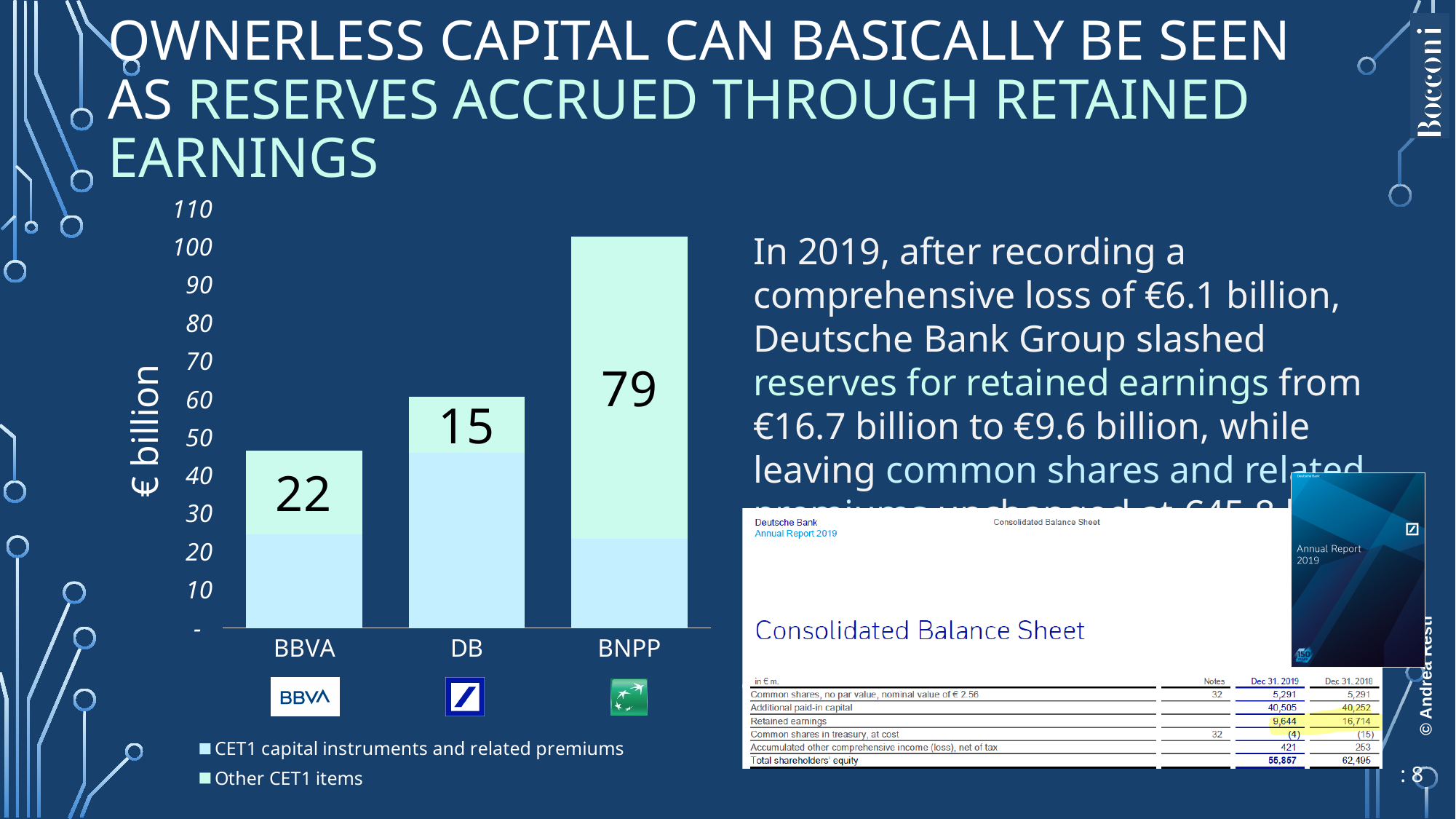
Which bank has the highest value for Other CET1 items? BNPP What is the value of Other CET1 items for BNPP? 79 Which is larger, the Other CET1 items value for BBVA or for DB? BBVA How many banks are shown on the x axis of the chart? 3 Is the total height of the BNPP bar greater or less than 100? greater What is the difference between the Other CET1 items values for BNPP and BBVA? 57 What is the value of Other CET1 items for DB? 15 Is the value of CET1 capital instruments and related premiums for DB greater or less than 40? greater Which bank has the lowest value for Other CET1 items? DB What type of chart is shown on the slide? Stacked bar chart What is the value of Other CET1 items for BBVA? 22 How many series does the chart legend list? 2